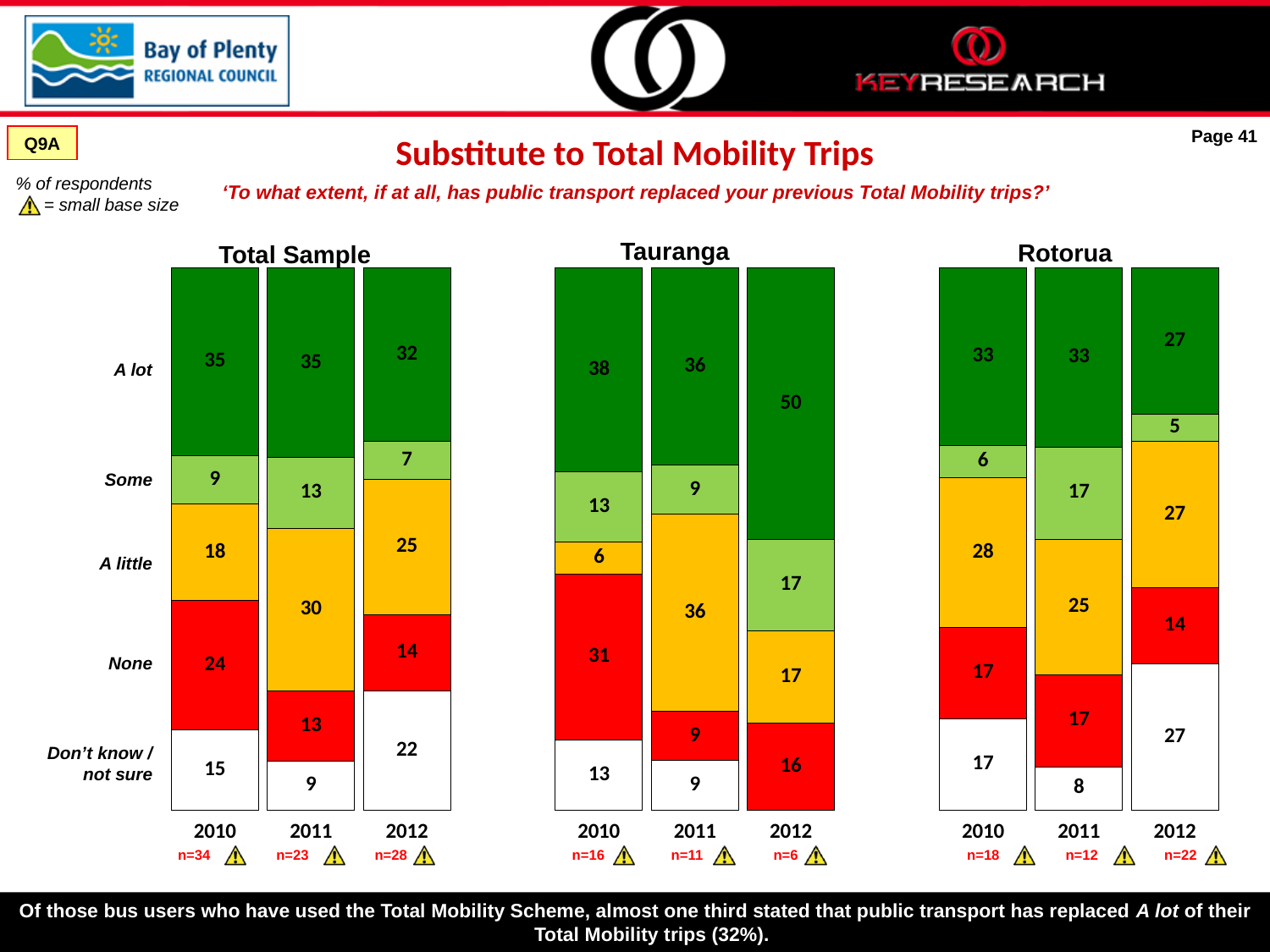
What is the base size (n) for the Tauranga 2012 bar? n=6 How many bars (years) are shown in the Total Sample chart? 3 In the Rotorua chart, which year has the lowest value for 'Don't know / not sure'? 2011 In the Total Sample chart, what is the difference between the 'A little' values for 2011 and 2010? 12 In the Rotorua chart, what is the value for 'A little' in 2011? 25 In the Total Sample chart, does the 'Don't know / not sure' value rise or fall from 2011 to 2012? Rise In the Tauranga chart, what is the value for 'None' in 2010? 31 In the Rotorua chart, is the 'A little' value larger in 2010 or in 2012? 2010 In the Tauranga chart, what is the total of the stacked bar for 2012? 100 What type of chart is used for the Rotorua data? Stacked bar chart In the Tauranga chart, which year has the highest value for 'A lot'? 2012 In the Total Sample chart, what percentage of respondents said public transport replaced 'A lot' of their Total Mobility trips in 2012? 32